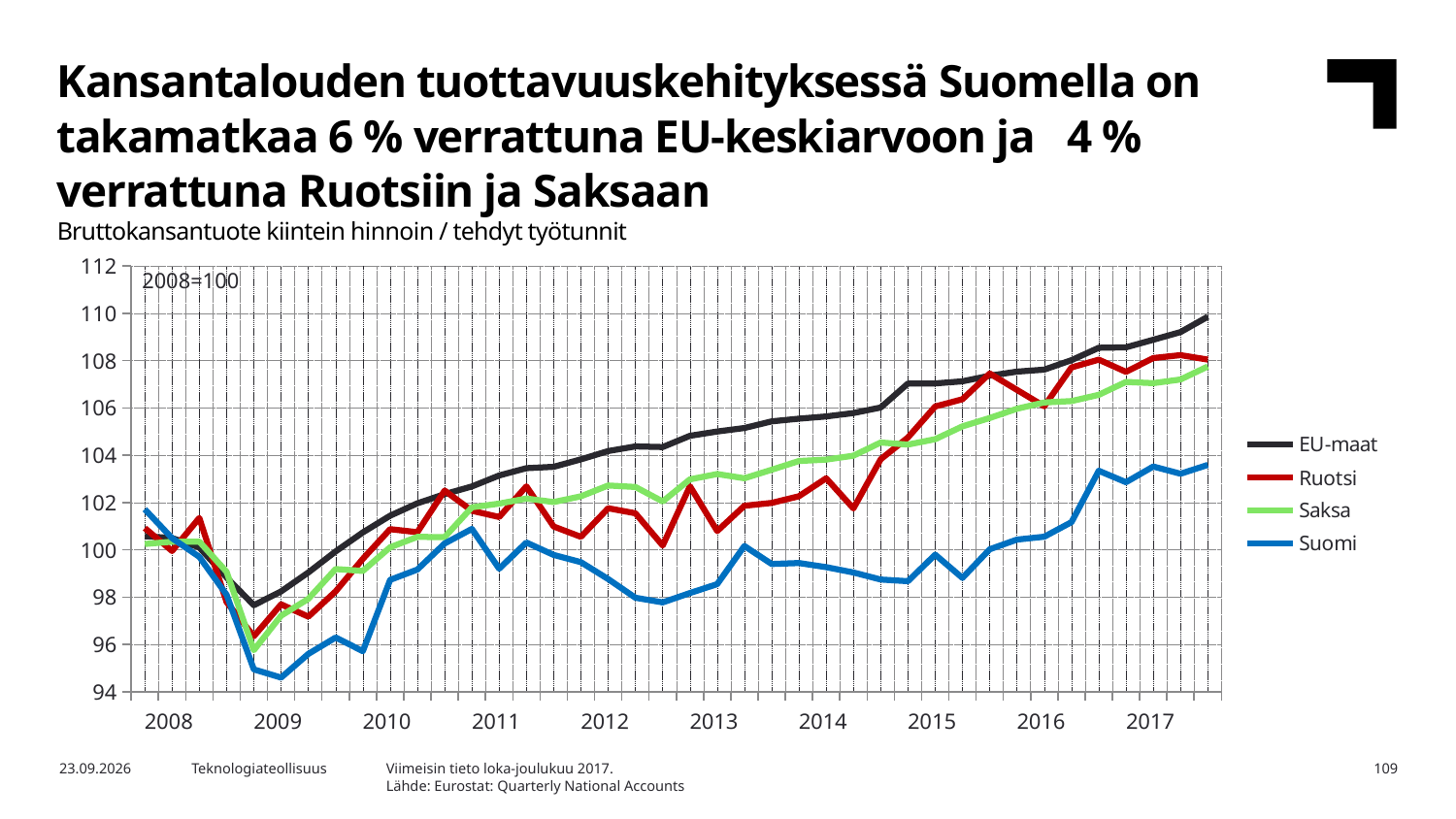
At the end of 2017, which is larger: the value for EU-maat or the value for Suomi? EU-maat What kind of chart is shown on the slide? line chart Is the lowest value for Suomi in 2009 greater or less than 96? less Which series has the highest value at the end of 2017? EU-maat Which series has the lowest value at the end of 2017? Suomi Is the value for EU-maat at the end of 2017 greater or less than 108? greater Is the value for Suomi at the end of 2017 greater or less than 102? greater Which series fell to the lowest level in 2009? Suomi How many series does the legend list? 4 What base-year note is printed inside the chart area? 2008=100 Does the EU-maat series rise or fall from 2010 to 2017? rise